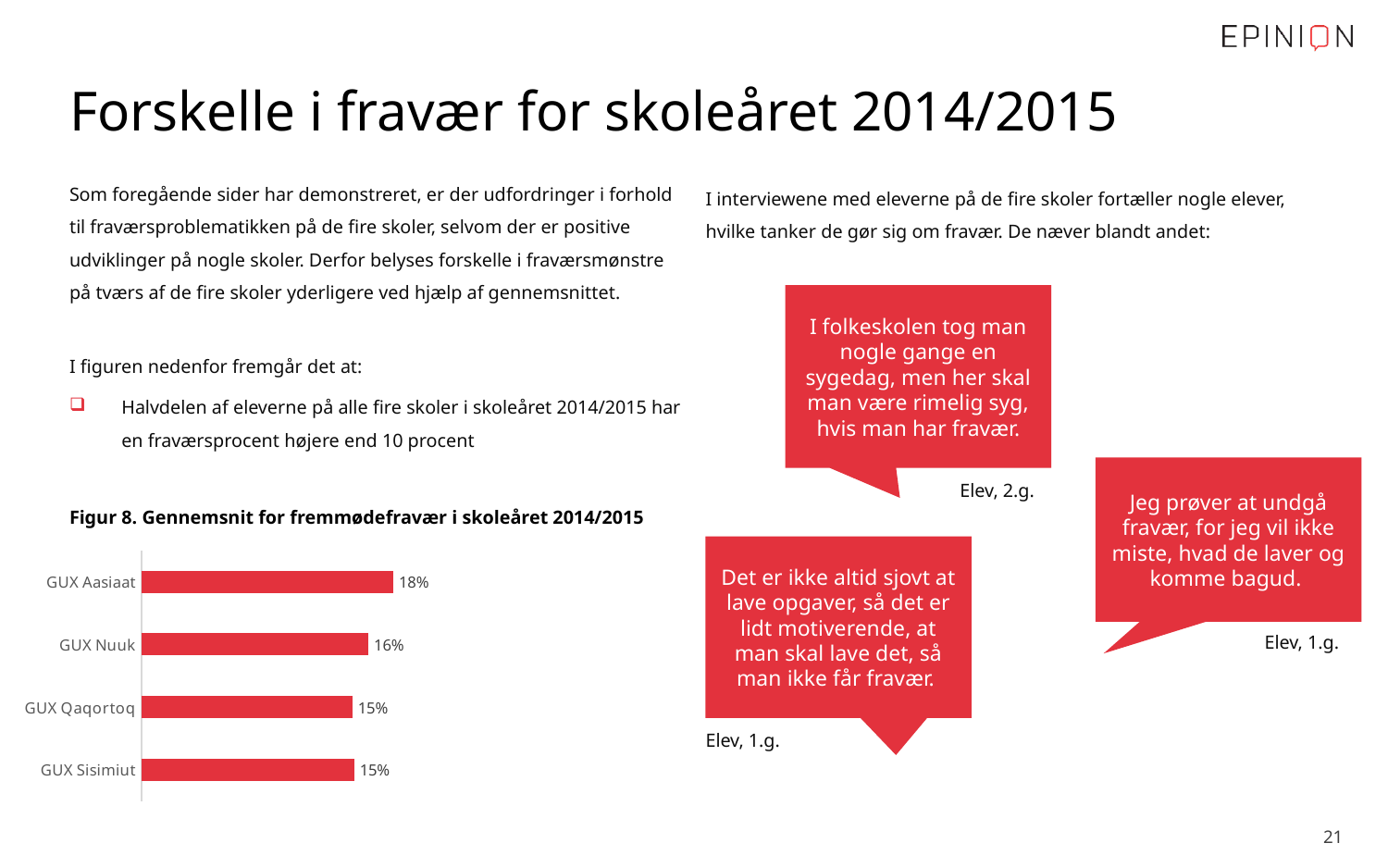
What colour are the bars in the chart? Red What kind of chart is shown on the slide? Bar chart What is the difference between the values for GUX Aasiaat and GUX Sisimiut? 3% What is the value for GUX Sisimiut? 15% What is the value for GUX Nuuk? 16% What is the difference between the values for GUX Aasiaat and GUX Nuuk? 2% What is the value for GUX Qaqortoq? 15% What is the value for GUX Aasiaat? 18% Which is larger, the value for GUX Nuuk or the value for GUX Qaqortoq? GUX Nuuk How many schools are shown in the chart? 4 What is the title of the chart? Figur 8. Gennemsnit for fremmødefravær i skoleåret 2014/2015 Which school has the highest value in the chart? GUX Aasiaat